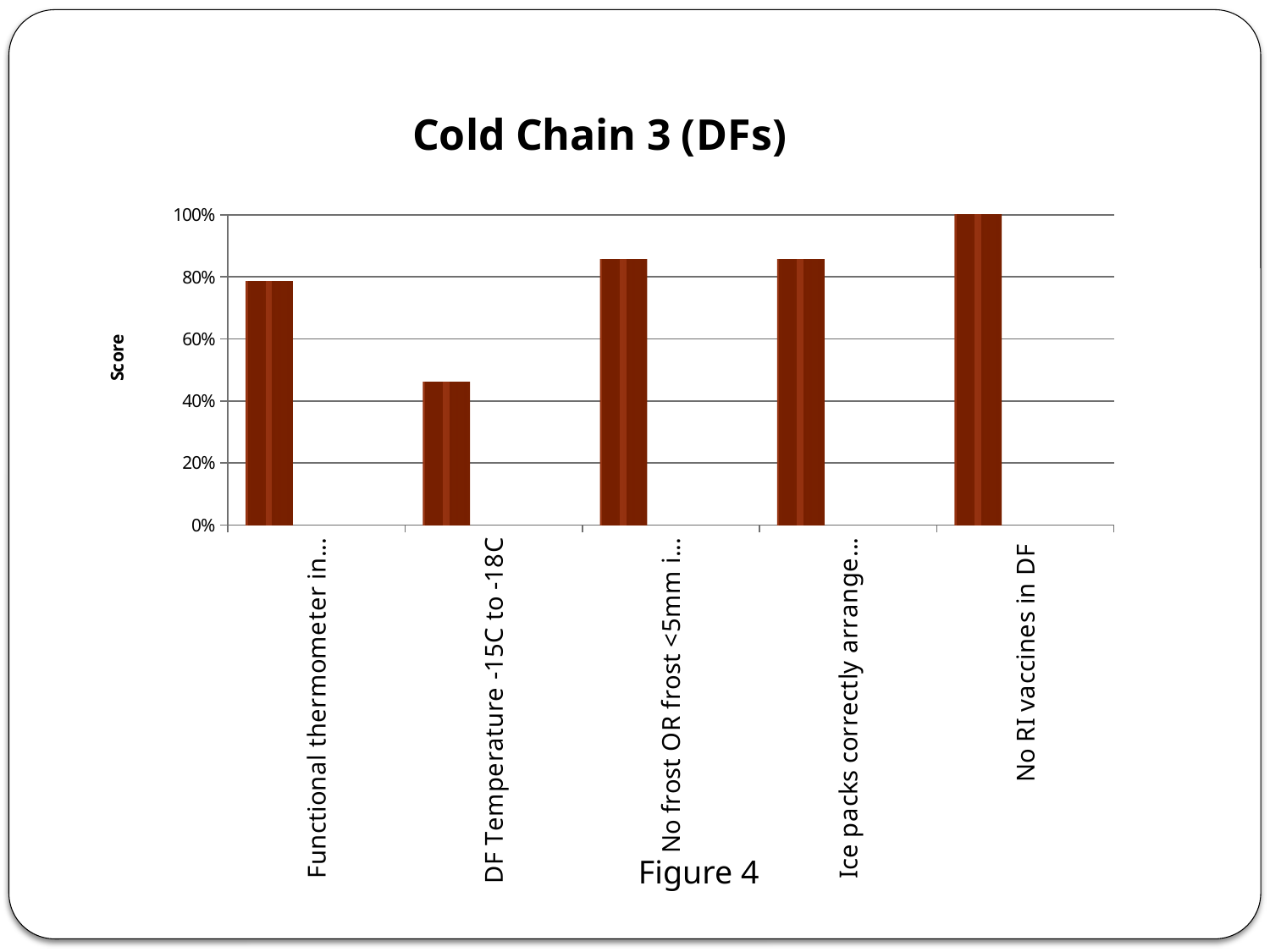
Which category has the highest score? No RI vaccines in DF Is the score for DF Temperature -15C to -18C greater or less than 60%? less What kind of chart is shown on the slide? bar chart Which category has the lowest score? DF Temperature -15C to -18C Is the score for the first bar from the left (Functional thermometer in...) greater or less than 60%? greater Which has a higher score: DF Temperature -15C to -18C or No RI vaccines in DF? No RI vaccines in DF Which has a higher score: the first bar from the left (Functional thermometer in...) or DF Temperature -15C to -18C? Functional thermometer in... What is the title of the chart? Cold Chain 3 (DFs) Is the score for the third bar from the left (No frost OR frost <5mm i...) greater or less than 80%? greater How many bars (categories) are plotted in the chart? 5 What is the score for No RI vaccines in DF? 100% What is the label on the vertical axis of the chart? Score